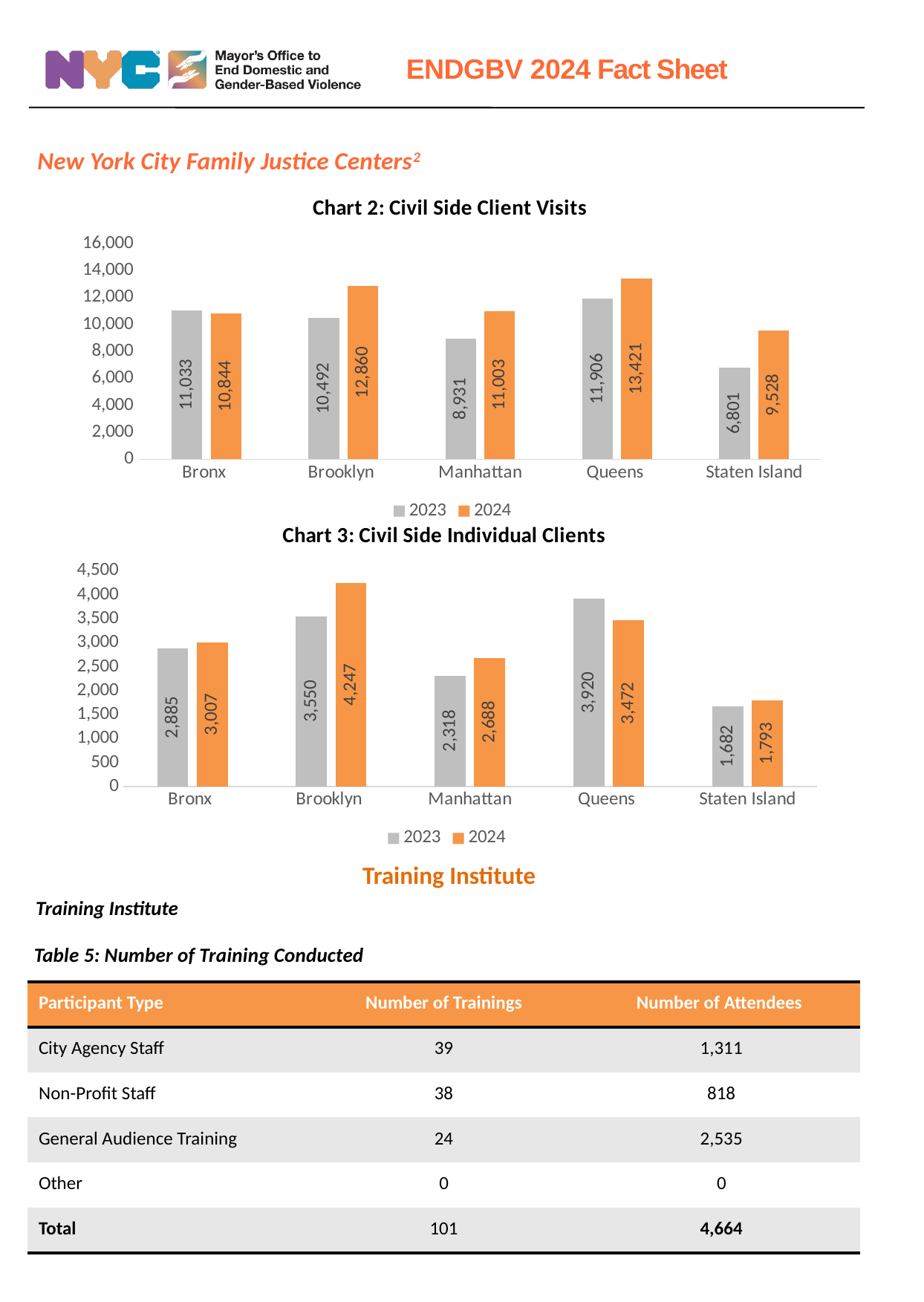
In Chart 2: Civil Side Client Visits, what is the difference between the 2024 and 2023 values for Manhattan? 2,072 How many series does the legend of Chart 2: Civil Side Client Visits list? 2 In Chart 2: Civil Side Client Visits, what is the 2023 value for Staten Island? 6,801 In Chart 2: Civil Side Client Visits, which is larger for the Bronx, the 2023 value or the 2024 value? 2023 In Chart 3: Civil Side Individual Clients, what is the 2024 value for Manhattan? 2,688 In Chart 3: Civil Side Individual Clients, what is the 2023 value for Queens? 3,920 In Chart 3: Civil Side Individual Clients, which borough has the highest 2024 value? Brooklyn In Chart 2: Civil Side Client Visits, which borough has the highest 2024 value? Queens In Chart 2: Civil Side Client Visits, which borough has the lowest 2023 value? Staten Island How many boroughs are shown on the x axis of Chart 3: Civil Side Individual Clients? 5 In Chart 2: Civil Side Client Visits, what is the 2024 value for Brooklyn? 12,860 In Chart 3: Civil Side Individual Clients, what is the difference between the 2024 and 2023 values for Brooklyn? 697